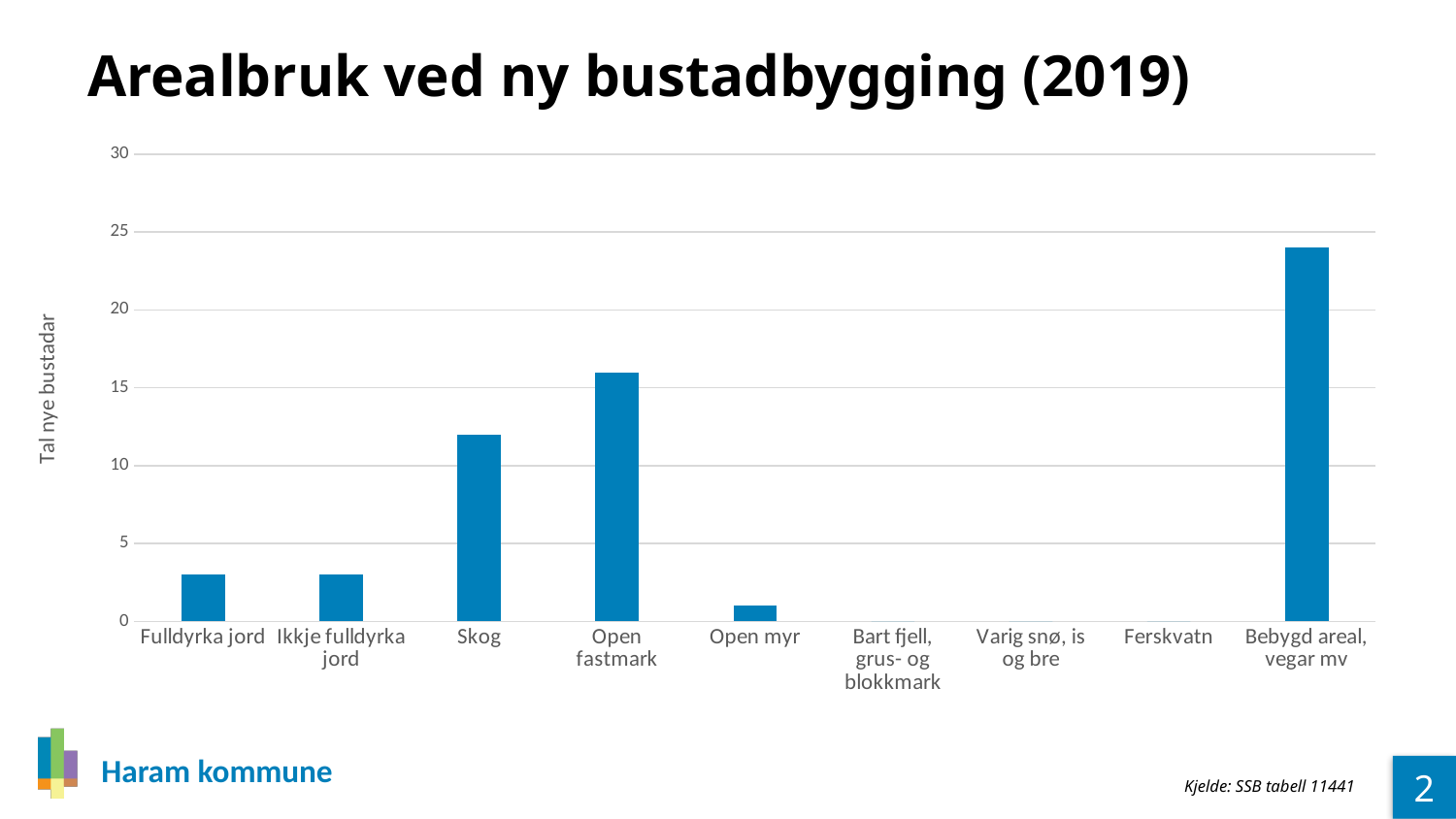
Which has the larger value, Skog or Open fastmark? Open fastmark Is the value for Bebygd areal, vegar mv greater or less than 20? greater Which has the larger value, Open fastmark or Bebygd areal, vegar mv? Bebygd areal, vegar mv Is the value for Open myr greater or less than 5? less How many categories are shown on the x axis of the chart? 9 What is the label on the vertical axis of the chart? Tal nye bustadar What kind of chart is shown on the slide? bar chart What is the title of the chart on the slide? Arealbruk ved ny bustadbygging (2019) Which category has the highest value in the chart? Bebygd areal, vegar mv Is the value for Skog greater or less than 15? less